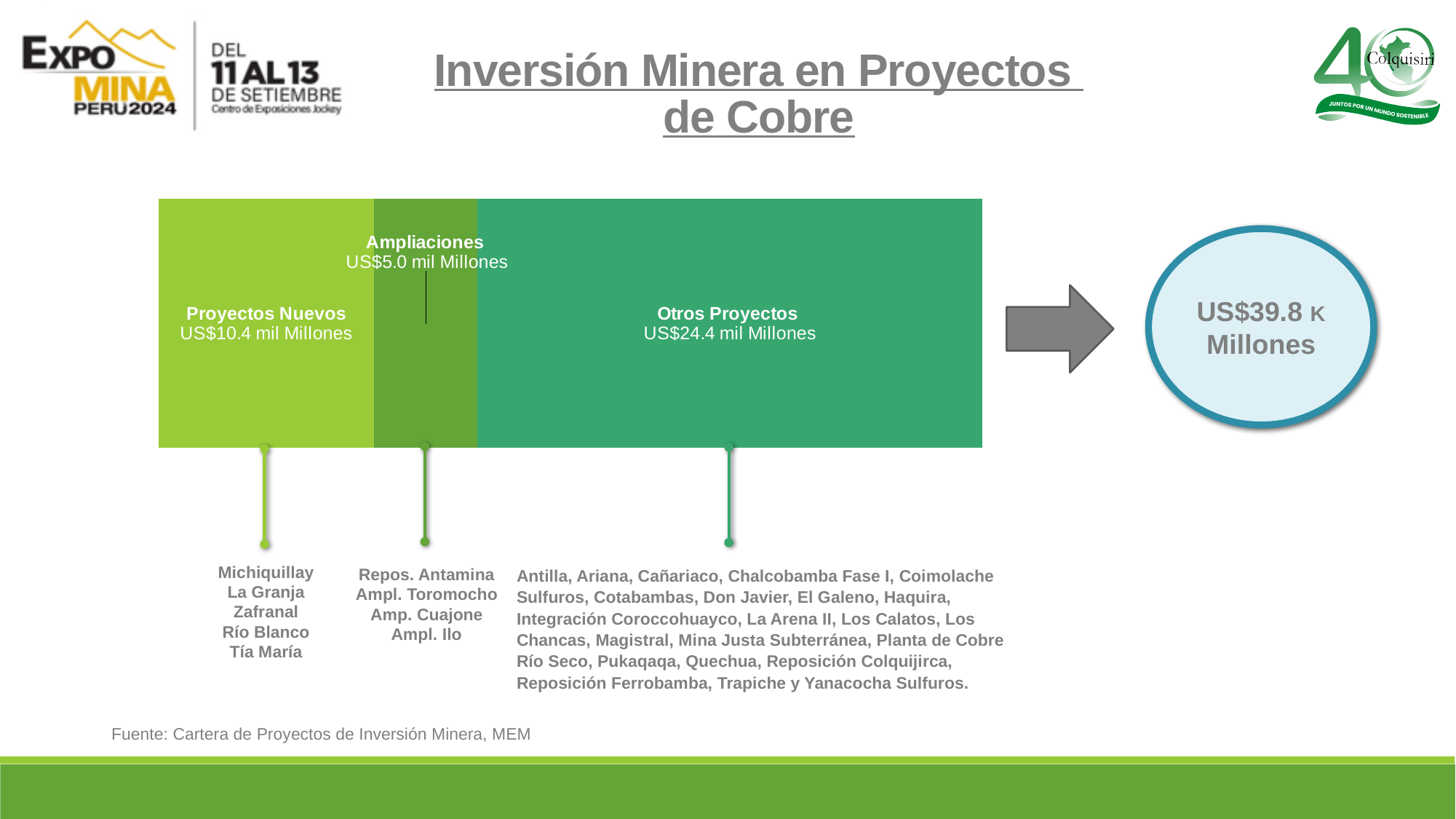
Which segment of the bar has the highest value? Otros Proyectos What is the title of the chart? Inversión Minera en Proyectos de Cobre What is the value for Ampliaciones? US$5.0 mil Millones What kind of chart is shown on the slide? Stacked bar chart Which is larger, Proyectos Nuevos or Ampliaciones? Proyectos Nuevos What is the total of the stacked bar, as shown in the circle on the right? US$39.8 K Millones What is the difference between Proyectos Nuevos and Ampliaciones, in mil Millones? US$5.4 mil Millones Which segment of the bar has the lowest value? Ampliaciones What is the value for Otros Proyectos? US$24.4 mil Millones What is the difference between Otros Proyectos and Proyectos Nuevos, in mil Millones? US$14.0 mil Millones What is the value for Proyectos Nuevos? US$10.4 mil Millones How many segments make up the stacked bar? 3